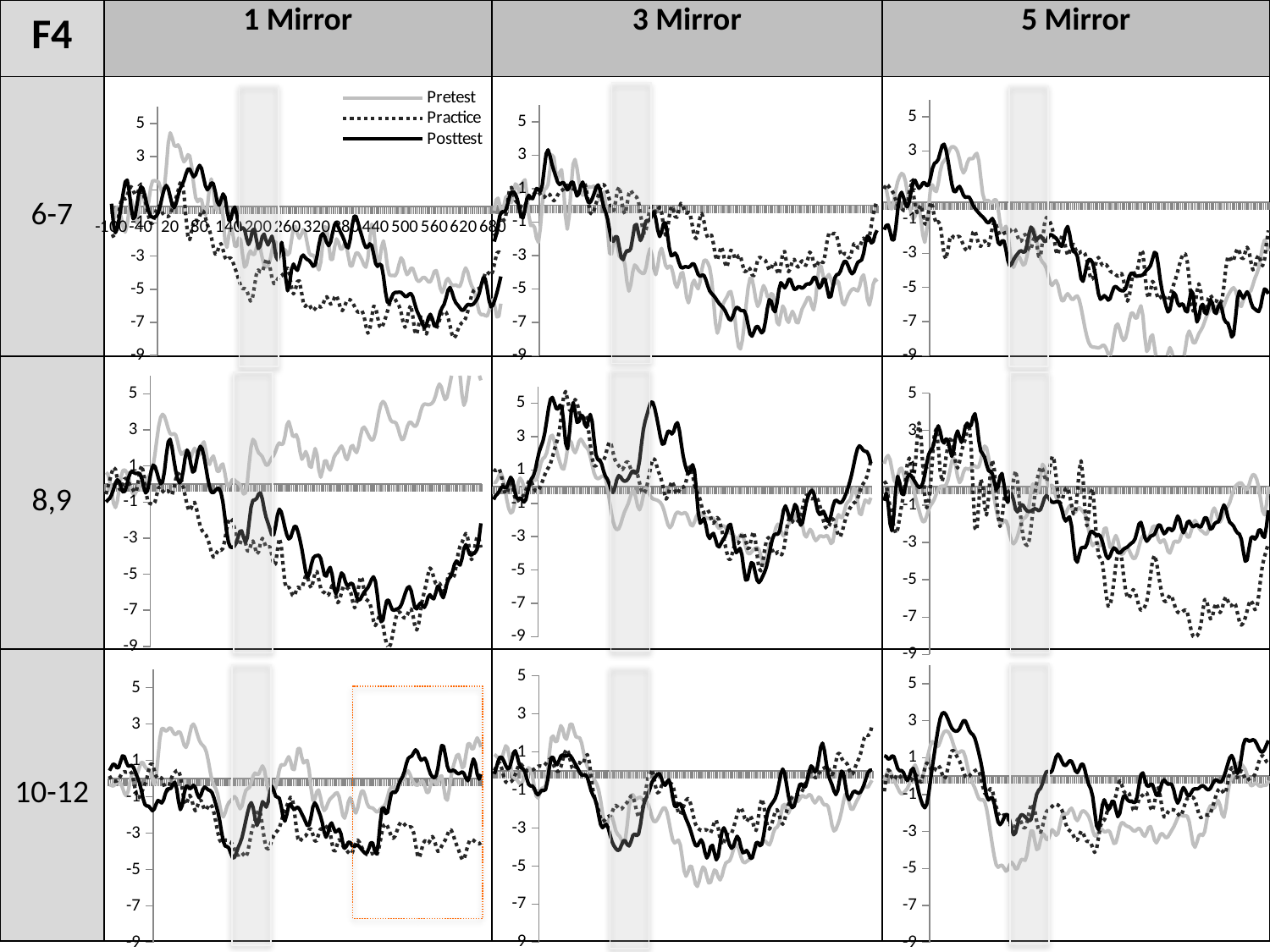
In the 1 Mirror, 8,9 chart, does the Pretest line rise or fall between x = 200 and x = 680? rises In the 1 Mirror, 8,9 chart, is the lowest value of the Practice line greater or less than -7? less How many series does the legend in the 1 Mirror, 6-7 chart list? 3 What are the three column headings above the charts? 1 Mirror, 3 Mirror, 5 Mirror In the 5 Mirror, 6-7 chart, is the lowest value of the Pretest line greater or less than -5? less What kind of chart is used in each panel of the F4 grid? line chart In the 5 Mirror, 10-12 chart, is the lowest value of the Pretest line greater or less than -3? less How many charts are shown on the slide? 9 What are the three series named in the legend of the 1 Mirror, 6-7 chart? Pretest, Practice, Posttest